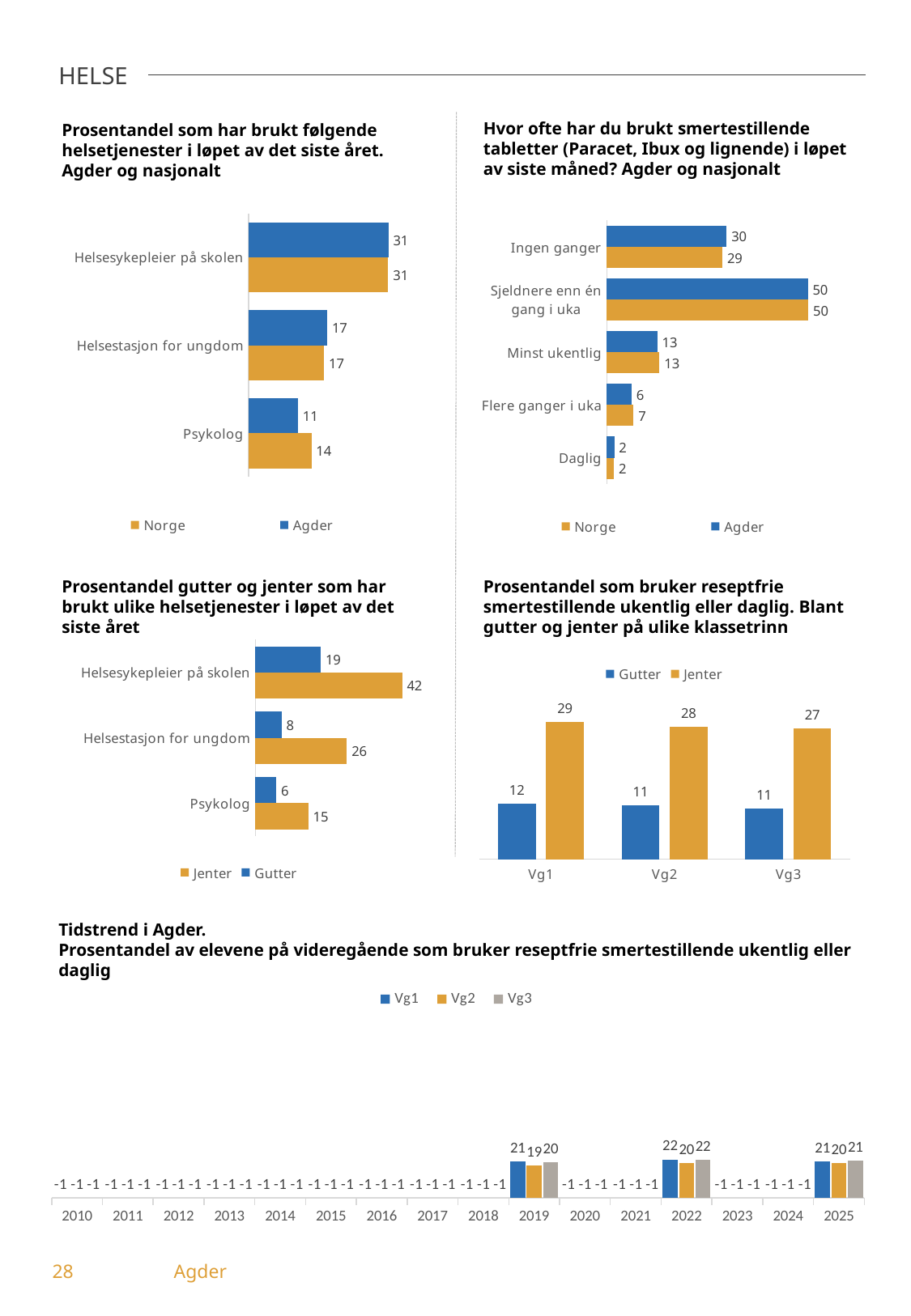
In the chart 'Prosentandel gutter og jenter som har brukt ulike helsetjenester', what is the difference between Jenter and Gutter for Helsestasjon for ungdom? 18 In the chart 'Hvor ofte har du brukt smertestillende tabletter', what is the Agder value for Ingen ganger? 30 In the chart 'Prosentandel som bruker reseptfrie smertestillende ukentlig eller daglig', what is the value for Jenter in Vg2? 28 In the chart 'Prosentandel gutter og jenter som har brukt ulike helsetjenester', what is the value for Jenter for Helsesykepleier på skolen? 42 What kind of chart is 'Tidstrend i Agder'? Bar chart In the chart 'Prosentandel som har brukt følgende helsetjenester i løpet av det siste året', what is the difference between the Norge and Agder values for Psykolog? 3 In the chart 'Tidstrend i Agder', what is the value for Vg2 in 2019? 19 In the chart 'Prosentandel som bruker reseptfrie smertestillende ukentlig eller daglig', how many series does the legend list? 2 In the chart 'Prosentandel som bruker reseptfrie smertestillende ukentlig eller daglig', which is larger: Gutter in Vg1 or Jenter in Vg3? Jenter in Vg3 In the chart 'Hvor ofte har du brukt smertestillende tabletter', which category has the highest value? Sjeldnere enn én gang i uka In the chart 'Prosentandel som har brukt følgende helsetjenester i løpet av det siste året', what is the value for Psykolog in Norge? 14 In the chart 'Hvor ofte har du brukt smertestillende tabletter', how many categories are shown? 5